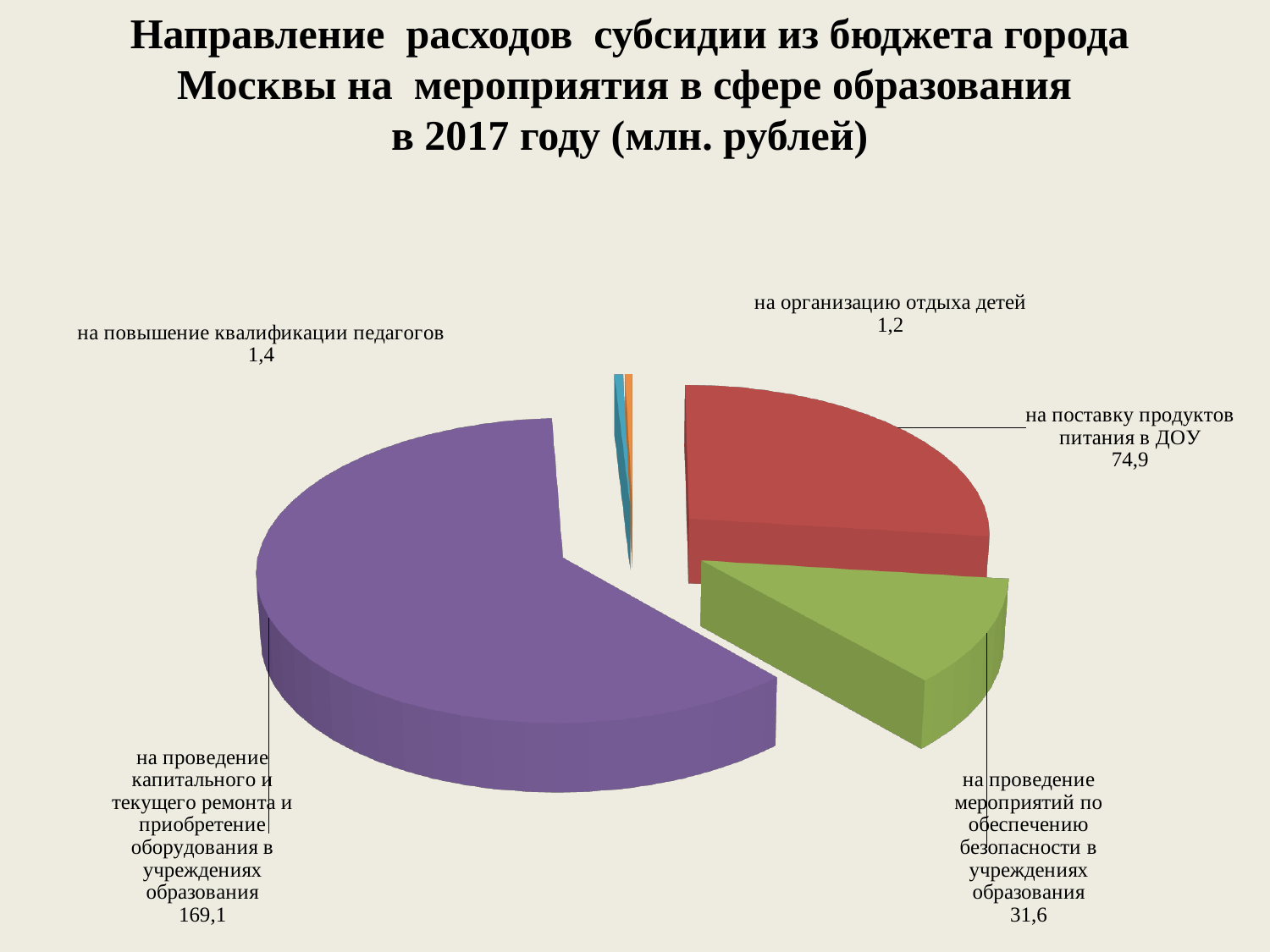
What is the difference between the value for "на проведение капитального и текущего ремонта и приобретение оборудования в учреждениях образования" and the value for "на поставку продуктов питания в ДОУ"? 94,2 What is the value for "на повышение квалификации педагогов"? 1,4 What is the value for "на организацию отдыха детей"? 1,2 What is the value for "на проведение мероприятий по обеспечению безопасности в учреждениях образования"? 31,6 What is the difference between the value for "на поставку продуктов питания в ДОУ" and the value for "на проведение мероприятий по обеспечению безопасности в учреждениях образования"? 43,3 What is the value for "на поставку продуктов питания в ДОУ"? 74,9 In what units are the values in the chart expressed, according to the title? млн. рублей What kind of chart is shown on the slide? pie chart Which category has the smallest value in the pie chart? на организацию отдыха детей How many slices does the pie chart have? 5 Which category has the largest value in the pie chart? на проведение капитального и текущего ремонта и приобретение оборудования в учреждениях образования Which is larger: the value for "на повышение квалификации педагогов" or the value for "на организацию отдыха детей"? на повышение квалификации педагогов